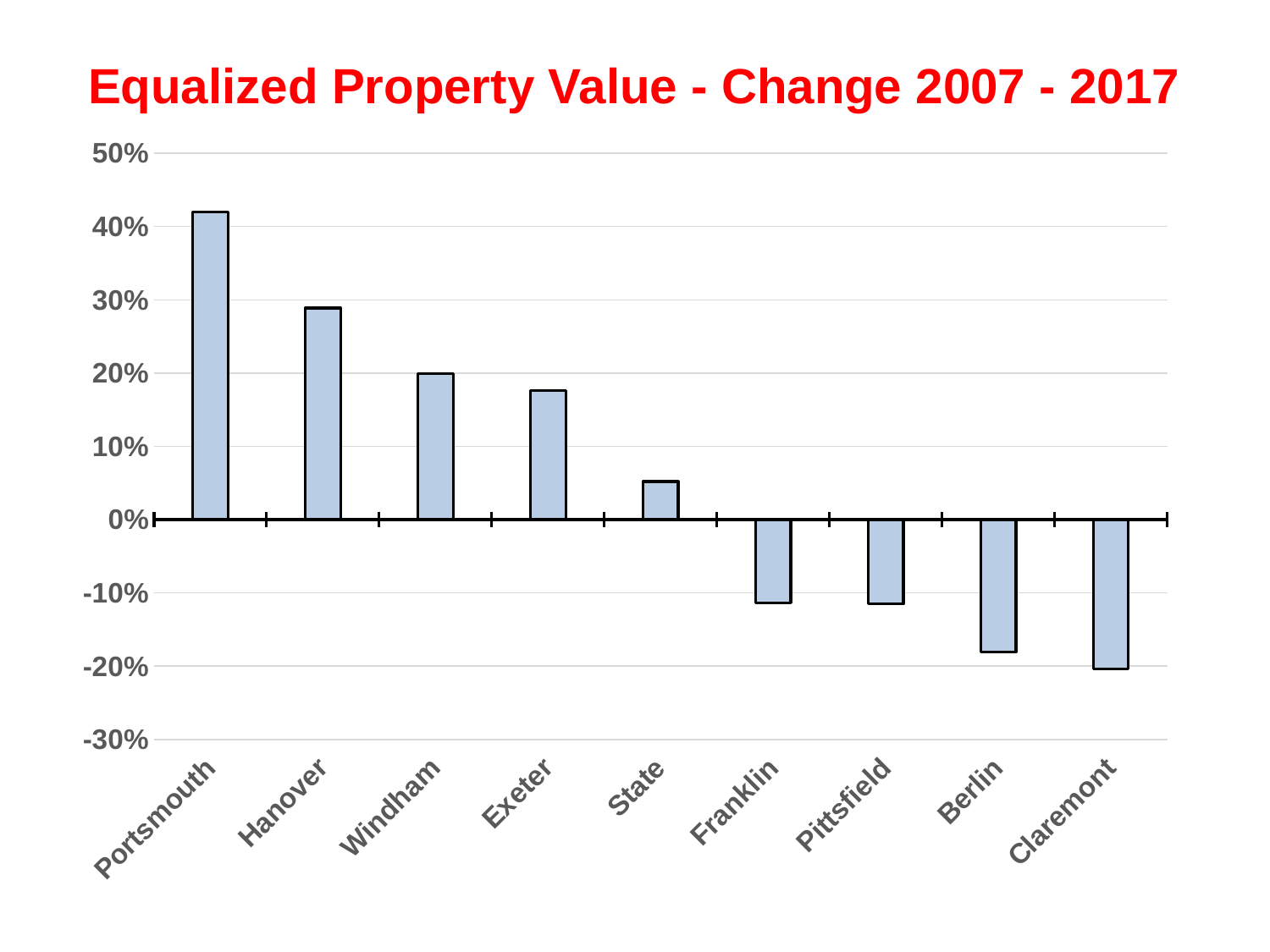
Which is larger, the value for Hanover or the value for Windham? Hanover Is the value for Portsmouth greater or less than 40%? greater How many categories are shown on the x axis? 9 Is the value for Exeter greater or less than 10%? greater Is the value for State greater or less than 10%? less Which category has the lowest value? Claremont What kind of chart is shown on the slide? bar chart What is the title of the chart? Equalized Property Value - Change 2007 - 2017 Do the values rise or fall moving from left to right along the x axis? fall Which category has the highest value? Portsmouth